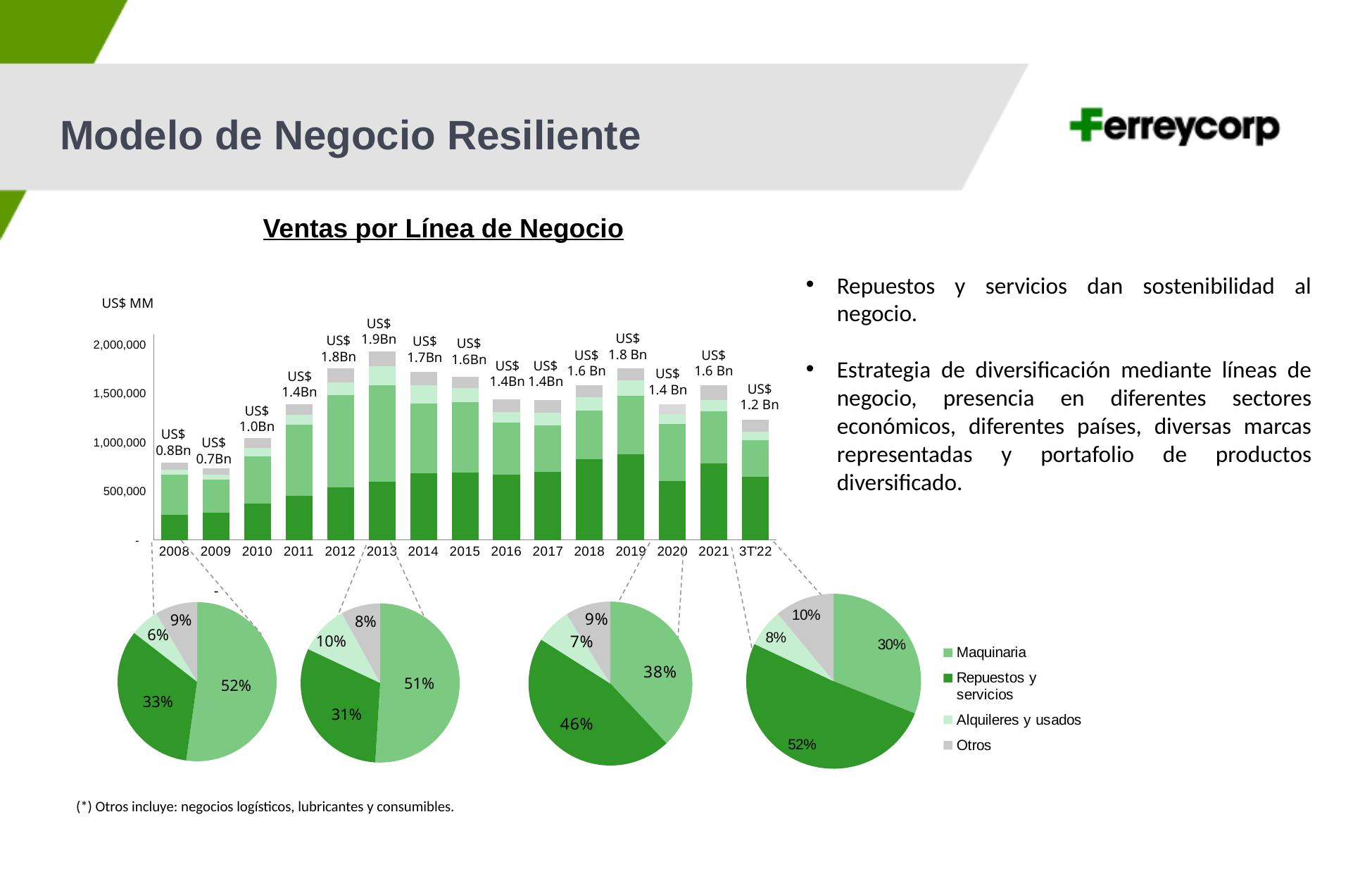
In the stacked bar chart, what is the total sales label shown for 2013? US$ 1.9Bn In the rightmost pie chart, what share does Repuestos y servicios have? 52% In the stacked bar chart, which year has the lowest total sales? 2009 How many series does the legend list for the charts? 4 In the third pie chart from the left, what is the difference between the Repuestos y servicios share and the Maquinaria share? 8% How many bars (periods) are shown in the stacked bar chart? 15 In the leftmost pie chart, what share does Maquinaria have? 52% In the stacked bar chart, which year has the highest total sales? 2013 In the stacked bar chart, is the total for 2016 greater or less than 1,500,000? less What type of chart is the main chart under the title 'Ventas por Línea de Negocio'? Stacked bar chart In the stacked bar chart, what is the total sales label shown for 3T'22? US$ 1.2 Bn In the stacked bar chart, is the total for 2012 greater or less than 1,500,000? greater